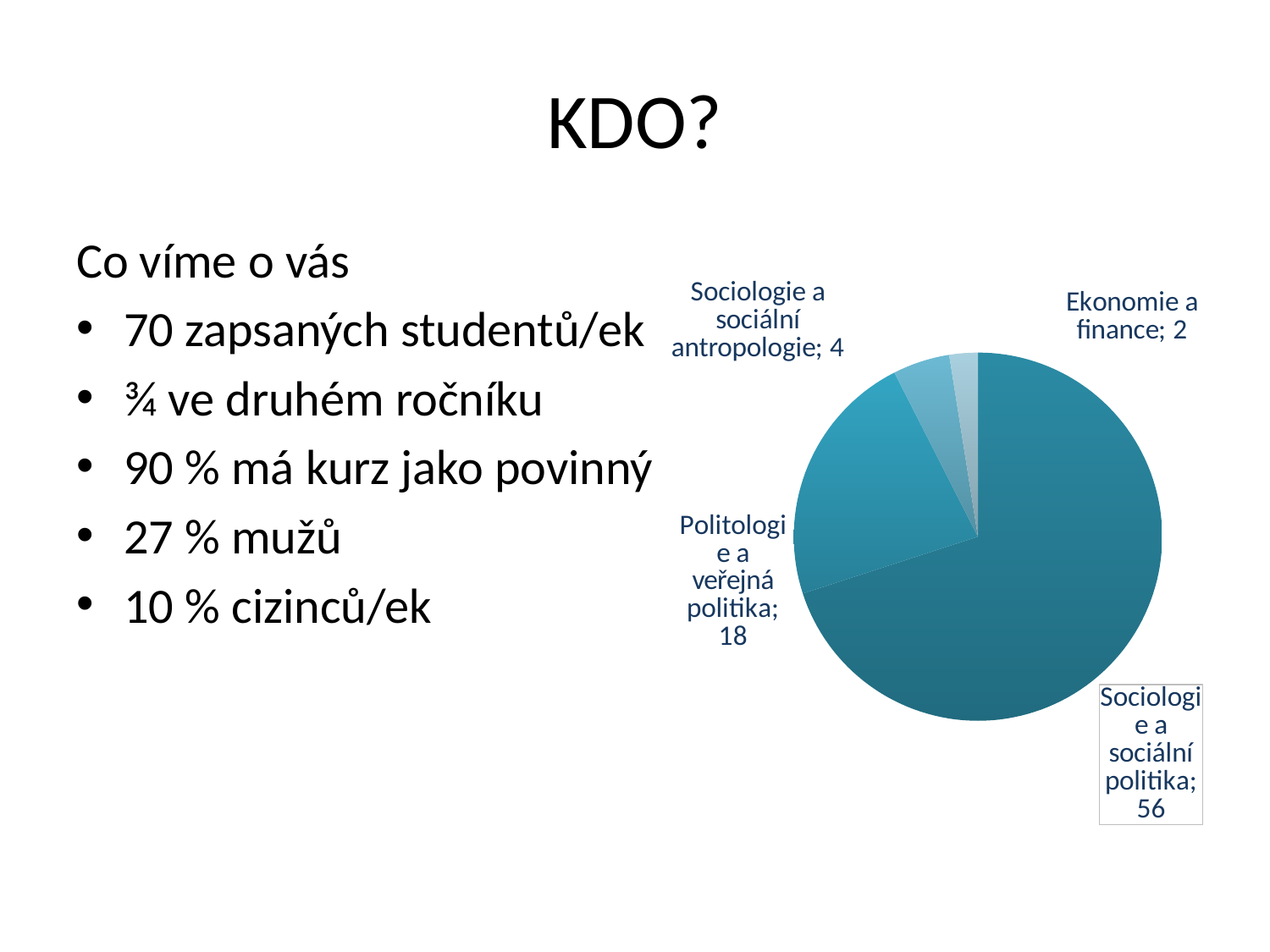
Which is larger, the value for Sociologie a sociální antropologie or the value for Ekonomie a finance? Sociologie a sociální antropologie What is the value for Politologie a veřejná politika in the pie chart? 18 What is the difference between the values for Sociologie a sociální politika and Politologie a veřejná politika? 38 What is the value for Ekonomie a finance in the pie chart? 2 What is the value for Sociologie a sociální antropologie in the pie chart? 4 How many slices does the pie chart have? 4 What is the total of all the values shown in the pie chart? 80 What kind of chart is shown on the slide? pie chart Which category has the smallest slice in the pie chart? Ekonomie a finance Which category has the largest slice in the pie chart? Sociologie a sociální politika What share of the pie does Sociologie a sociální politika represent? 70% What is the value for Sociologie a sociální politika in the pie chart? 56